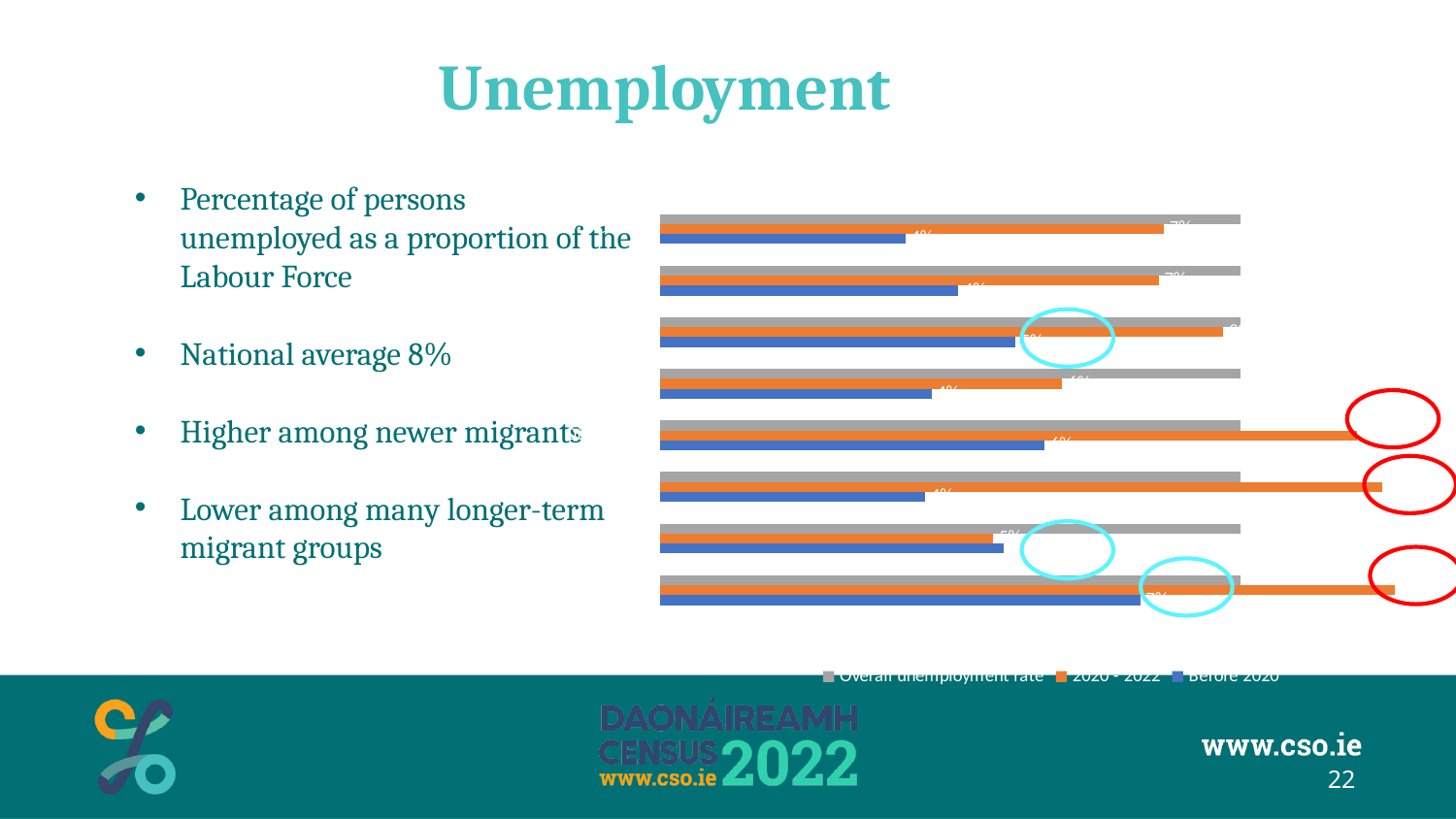
Which colour represents the "Before 2020" series in the chart? Blue What are the three series named in the chart's legend? Overall unemployment rate, 2020 - 2022, Before 2020 In the top group of bars, is the "2020 - 2022" bar longer or shorter than the "Before 2020" bar? Longer In the fifth group of bars from the top, which series has the longest bar? 2020 - 2022 In the bottom group of bars, is the "2020 - 2022" bar longer or shorter than the "Overall unemployment rate" bar? Longer How many series does the chart's legend list? 3 What kind of chart is shown on the slide? Bar chart How many groups of bars are plotted in the chart? 8